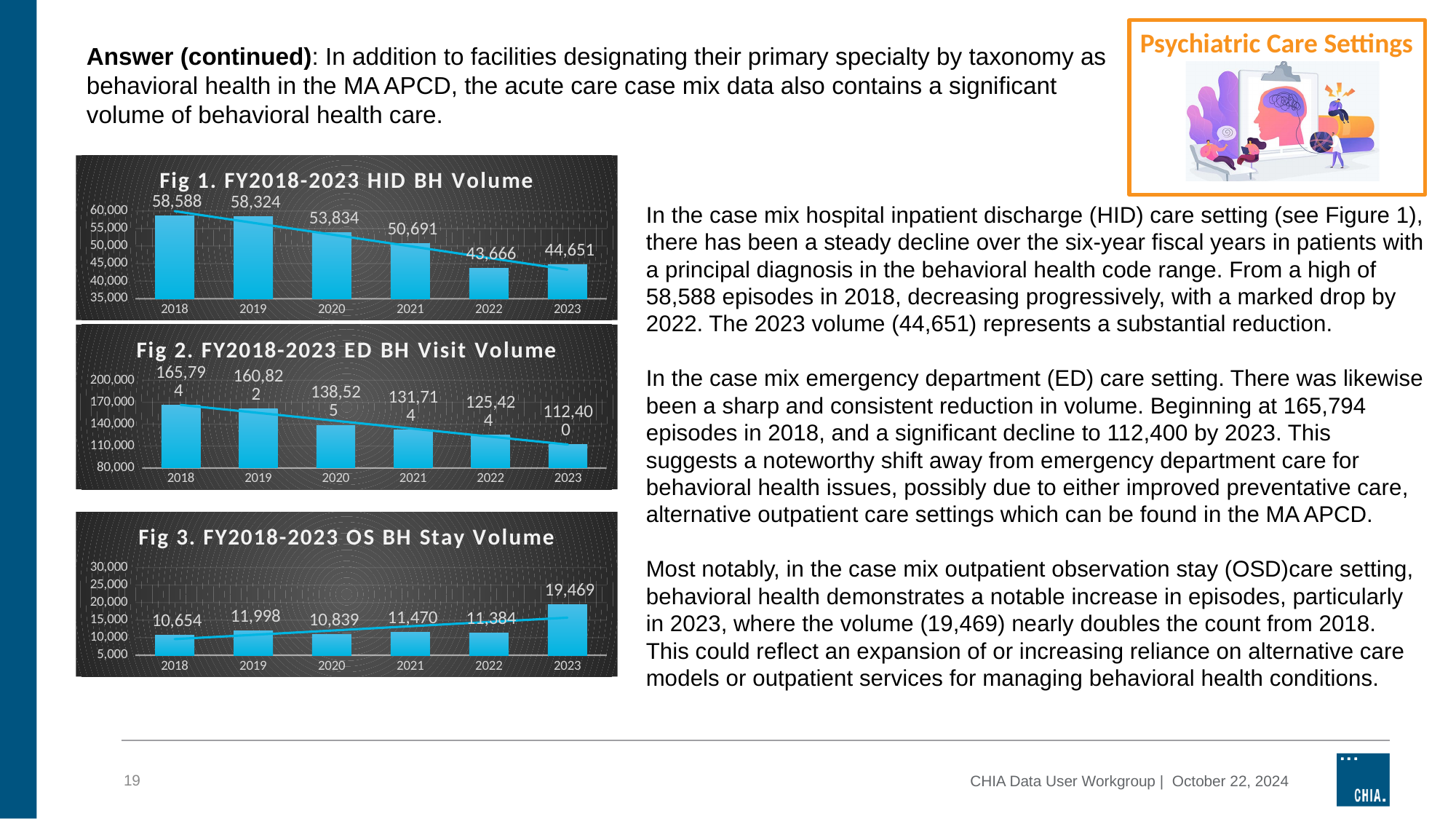
In the Fig 2. FY2018-2023 ED BH Visit Volume chart, which year has the highest value? 2018 In the Fig 2. FY2018-2023 ED BH Visit Volume chart, do the values rise or fall from 2018 to 2023? fall In the Fig 1. FY2018-2023 HID BH Volume chart, what is the difference between the 2018 and 2023 values? 13,937 In the Fig 1. FY2018-2023 HID BH Volume chart, how many years are shown on the x axis? 6 What kind of chart is the Fig 3. FY2018-2023 OS BH Stay Volume chart? bar chart In the Fig 2. FY2018-2023 ED BH Visit Volume chart, what is the difference between the 2018 and 2019 values? 4,972 In the Fig 3. FY2018-2023 OS BH Stay Volume chart, what is the value for 2022? 11,384 In the Fig 1. FY2018-2023 HID BH Volume chart, what is the value for 2020? 53,834 In the Fig 2. FY2018-2023 ED BH Visit Volume chart, what is the value for 2021? 131,714 In the Fig 3. FY2018-2023 OS BH Stay Volume chart, which is larger, the value for 2019 or the value for 2020? 2019 In the Fig 3. FY2018-2023 OS BH Stay Volume chart, which year has the highest value? 2023 In the Fig 1. FY2018-2023 HID BH Volume chart, which year has the lowest value? 2022